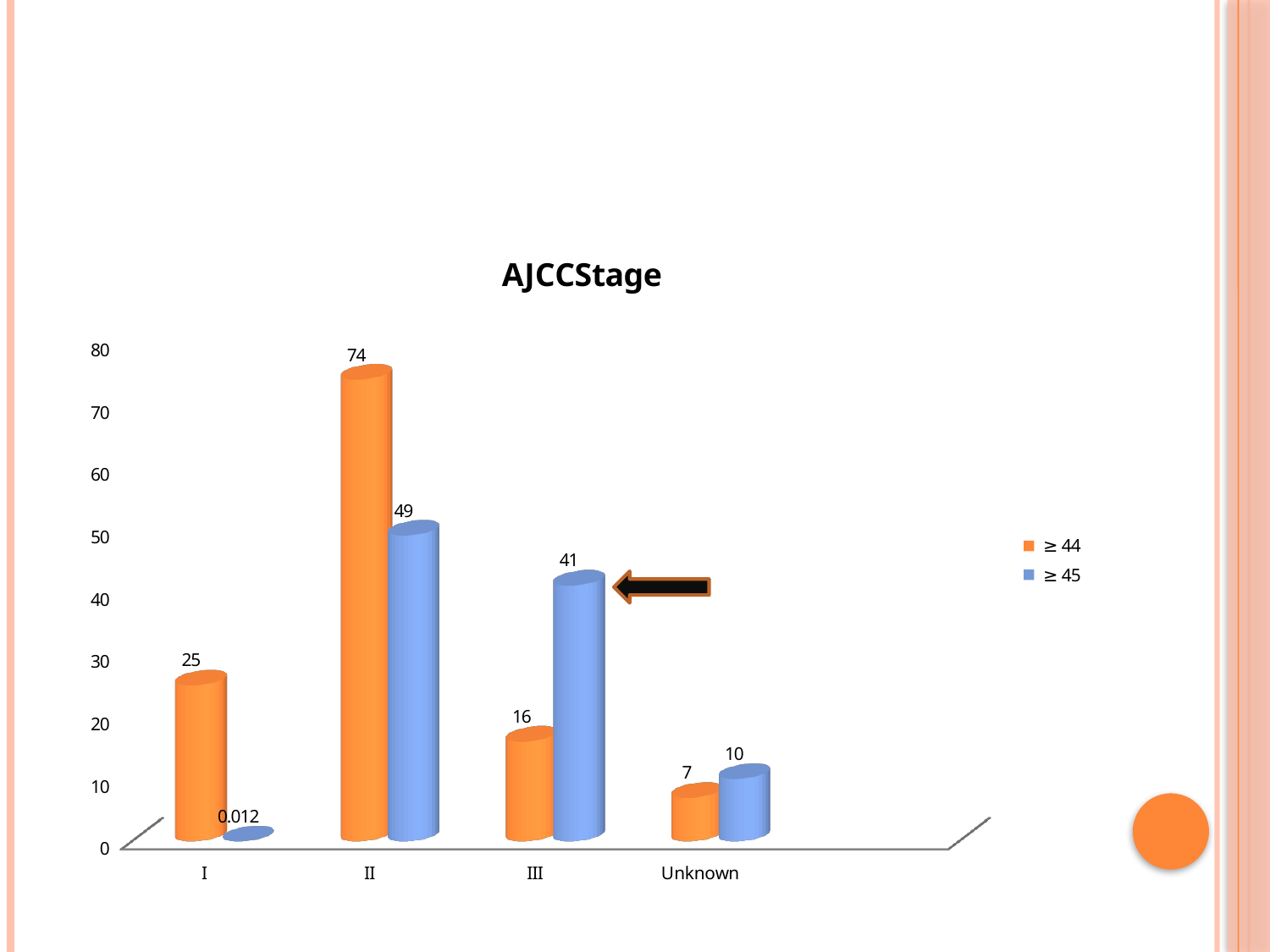
Which stage has the highest value in the ≥ 44 series? II What is the value for stage III in the ≥ 45 series? 41 How many series does the legend list? 2 For stage III, which series has the larger value, ≥ 44 or ≥ 45? ≥ 45 Which stage has the lowest value in the ≥ 45 series? I What kind of chart is shown on the slide? Bar chart What is the value for stage I in the ≥ 45 series? 0.012 What is the title of the chart? AJCCStage How many stage categories are shown on the x axis? 4 What is the difference between the ≥ 44 and ≥ 45 values for stage II? 25 What is the value for Unknown in the ≥ 44 series? 7 What is the value for stage II in the ≥ 44 series? 74